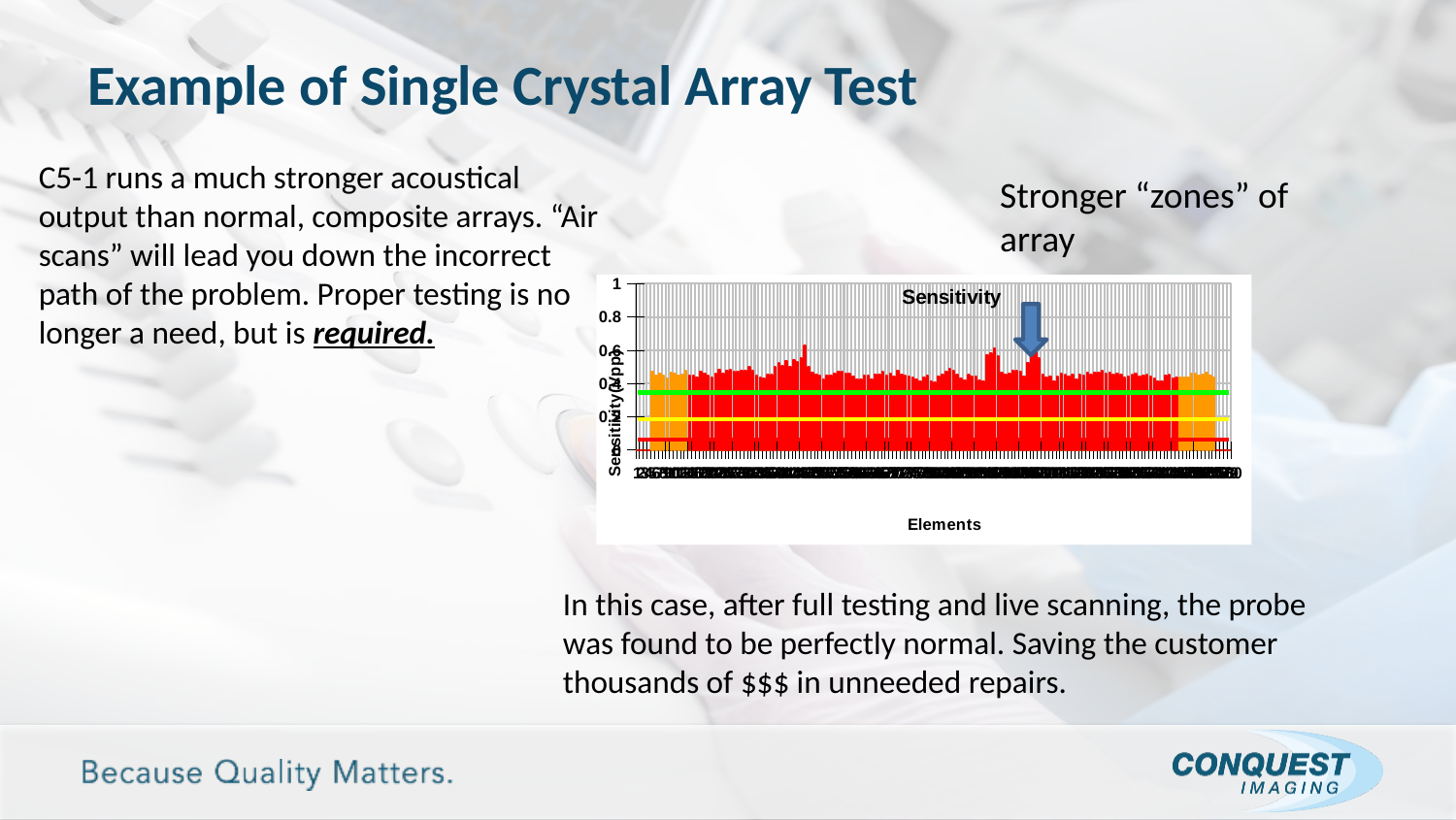
What is the title of the chart? Sensitivity What is the highest value shown on the y axis of the Sensitivity chart? 1 What is the label on the x axis of the chart? Elements What kind of chart is shown on the slide? bar chart Are the red bars in the Sensitivity chart generally greater or less than 0.2? greater Is the tallest bar in the Sensitivity chart greater or less than 0.8? less Are the red bars in the Sensitivity chart generally greater or less than 0.6? less